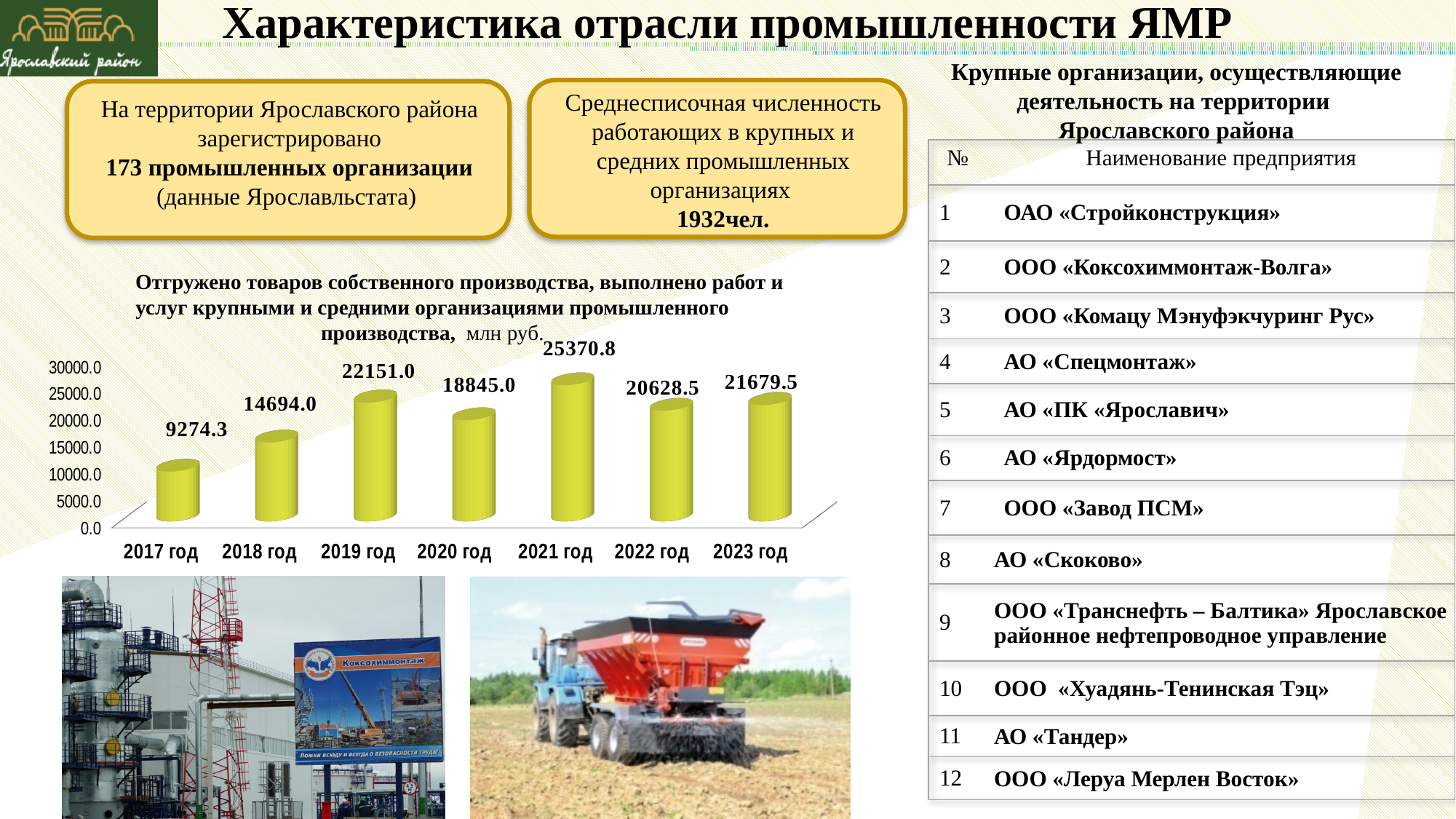
What kind of chart is shown on the slide? bar chart What is the value for 2021 год on the chart? 25370.8 How many years are shown on the chart? 7 Is the value for 2020 год greater or less than 20000.0? less What is the difference between the values for 2019 год and 2020 год? 3306.0 Which is larger, the value for 2022 год or the value for 2023 год? 2023 год What is the difference between the values for 2018 год and 2017 год? 5419.7 In what units are the values on the chart expressed, according to the chart title? млн руб. What is the value for 2023 год on the chart? 21679.5 What is the value for 2017 год on the chart? 9274.3 Which year has the lowest value on the chart? 2017 год Which year has the highest value on the chart? 2021 год